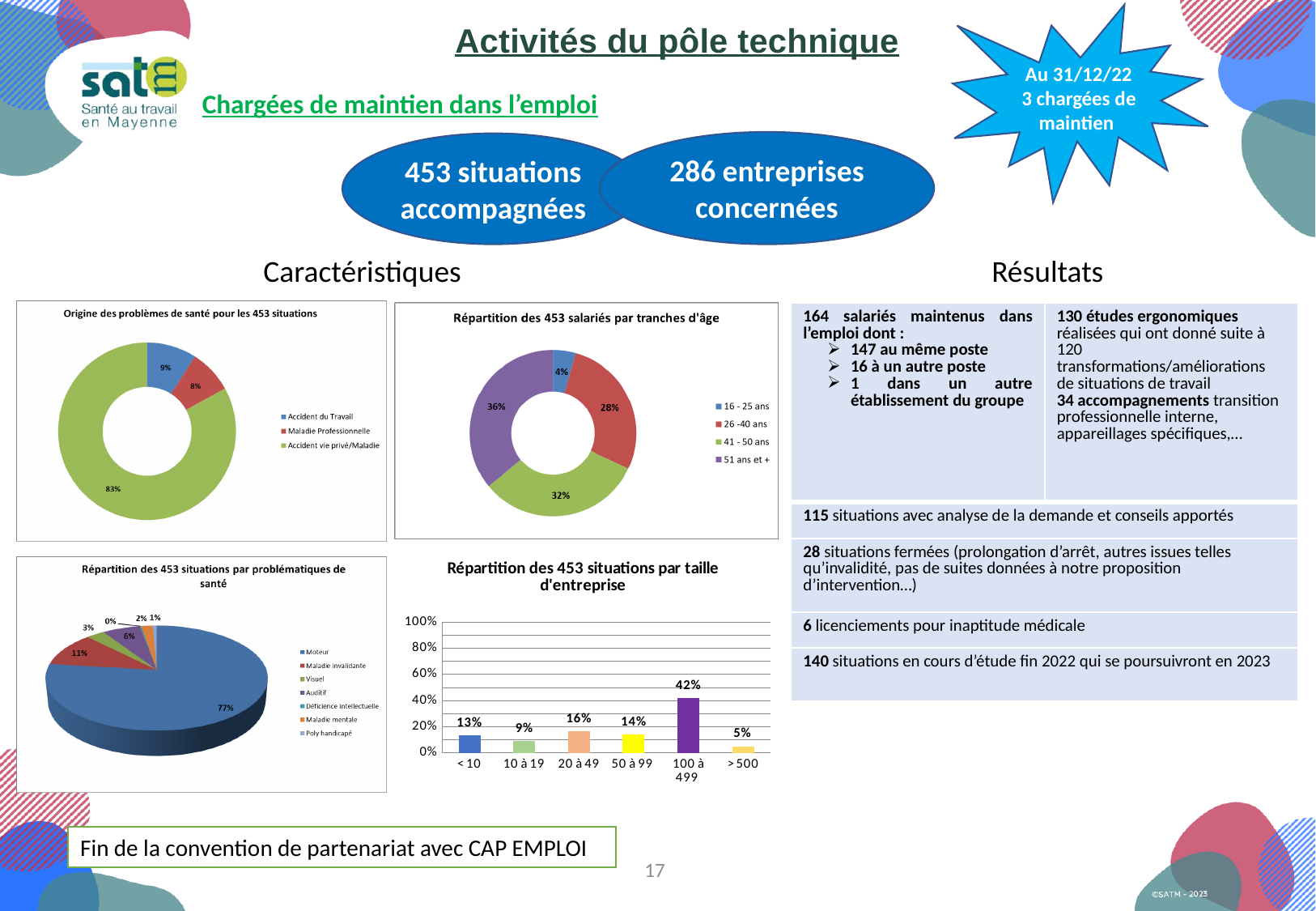
In the chart 'Répartition des 453 salariés par tranches d'âge', which age group has the smallest share? 16 - 25 ans In the chart 'Répartition des 453 situations par taille d'entreprise', how many company size categories are shown on the x axis? 6 How many age groups does the legend of 'Répartition des 453 salariés par tranches d'âge' list? 4 In the chart 'Répartition des 453 situations par problématiques de santé', what is the share of 'Moteur'? 77% What kind of chart is 'Répartition des 453 situations par taille d'entreprise'? Bar chart In the chart 'Répartition des 453 situations par taille d'entreprise', which company size category has the lowest value? > 500 In the chart 'Origine des problèmes de santé pour les 453 situations', which is larger: 'Accident du Travail' or 'Maladie Professionnelle'? Accident du Travail In the chart 'Répartition des 453 situations par taille d'entreprise', what is the value for the '100 à 499' category? 42% How many categories does the legend of 'Répartition des 453 situations par problématiques de santé' list? 7 In the chart 'Répartition des 453 salariés par tranches d'âge', what is the share of the '51 ans et +' age group? 36% In the chart 'Origine des problèmes de santé pour les 453 situations', what share is 'Accident vie privé/Maladie'? 83% In the chart 'Répartition des 453 situations par taille d'entreprise', what is the difference between the values for '20 à 49' and '10 à 19'? 7%